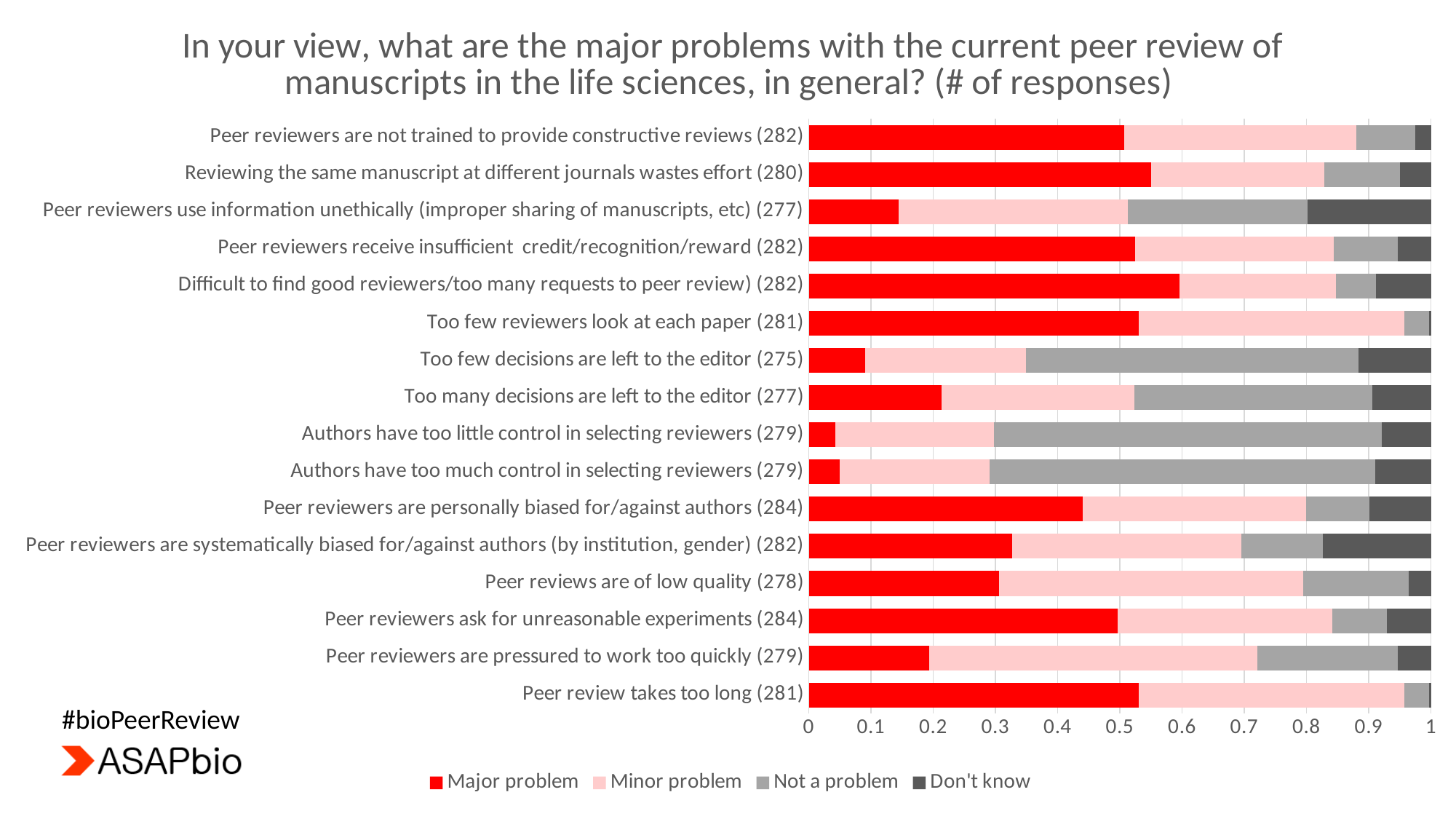
How many problem statements (categories) are listed on the chart? 16 Which series are listed in the legend? Major problem, Minor problem, Not a problem, Don't know How many series does the legend list? 4 Which has a larger 'Major problem' share: 'Peer reviewers are personally biased for/against authors (284)' or 'Peer reviewers are systematically biased for/against authors (by institution, gender) (282)'? Peer reviewers are personally biased for/against authors (284) Which has a larger 'Major problem' share: 'Too many decisions are left to the editor (277)' or 'Too few decisions are left to the editor (275)'? Too many decisions are left to the editor (277) Is the 'Major problem' share for 'Difficult to find good reviewers/too many requests to peer review) (282)' greater or less than 0.5? greater Is the 'Major problem' share for 'Peer reviewers are pressured to work too quickly (279)' greater or less than 0.3? less What kind of chart is shown on the slide? Stacked bar chart Which problem statement has the largest 'Major problem' share? Difficult to find good reviewers/too many requests to peer review) (282) Is the 'Major problem' share for 'Peer reviewers use information unethically (improper sharing of manuscripts, etc) (277)' greater or less than 0.1? greater What is the maximum value shown on the horizontal axis? 1